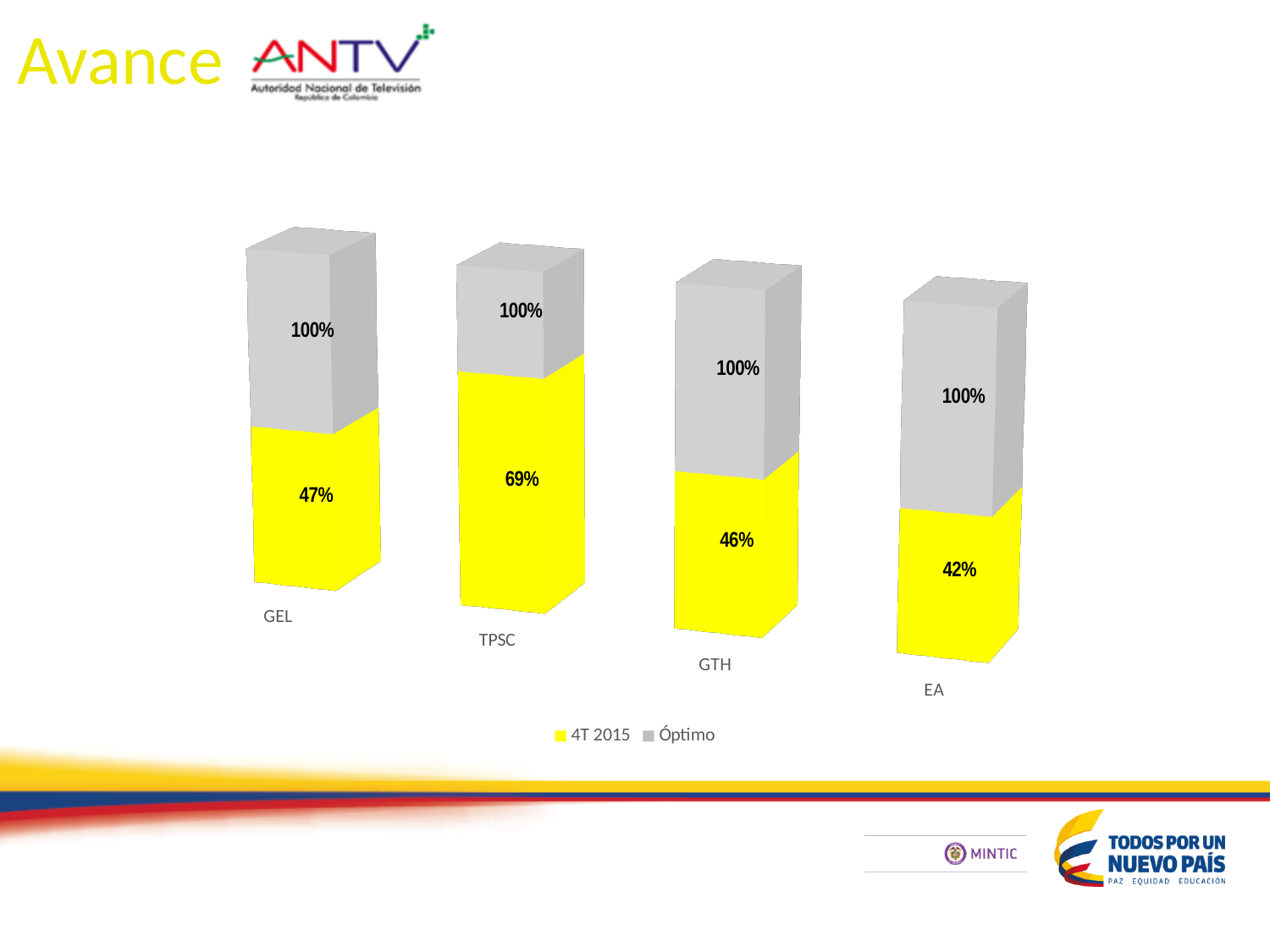
What is the 4T 2015 value for EA? 42% What is the 4T 2015 value for GTH? 46% What is the 4T 2015 value for GEL? 47% Which category has the lowest 4T 2015 value? EA Which has a larger 4T 2015 value, GEL or GTH? GEL What is the Óptimo value for GTH? 100% What is the difference between the 4T 2015 values for TPSC and EA? 27% What kind of chart is shown on the slide? Stacked bar chart How many series does the legend list? 2 What is the 4T 2015 value for TPSC? 69% Which category has the highest 4T 2015 value? TPSC How many categories are shown on the x axis? 4